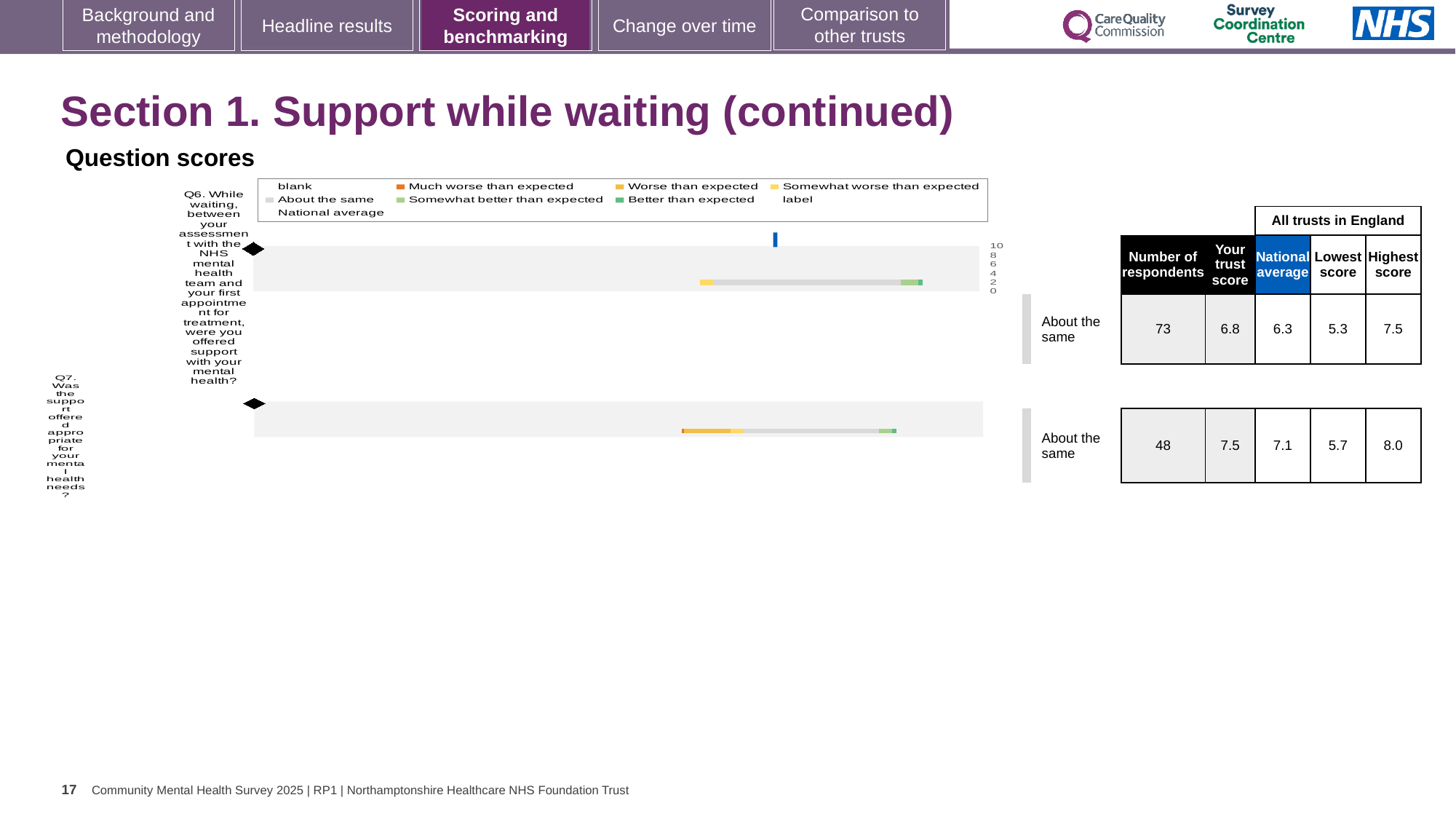
What is the 'Your trust score' for Q6 (support with your mental health while waiting)? 6.8 How many questions are plotted in the question scores chart? 2 What benchmark category is shown for Q6? About the same What is the difference between the trust score and the national average for Q7? 0.4 How many respondents answered Q6? 73 What is the national average score for Q7? 7.1 What is the maximum value shown on the score axis of the chart? 10 Which question has the higher trust score, Q6 or Q7? Q7 What is the highest score among all trusts in England for Q7? 8.0 What is the national average score for Q6? 6.3 What kind of chart is used to show the question scores for Q6 and Q7? bar chart What is the 'Your trust score' for Q7 (was the support offered appropriate for your mental health needs)? 7.5